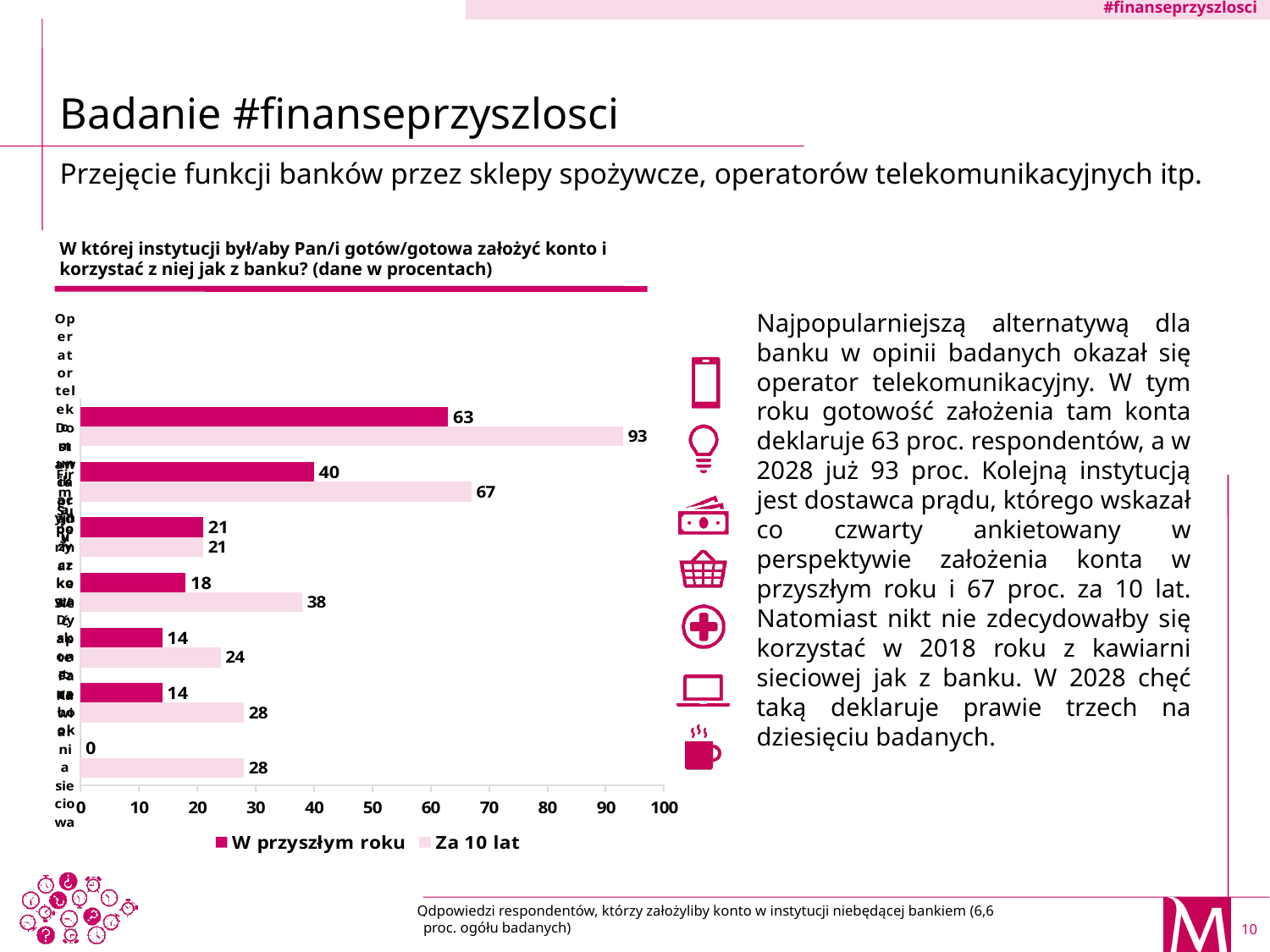
What is the highest value in the 'Za 10 lat' series? 93 What are the two series named in the chart legend? W przyszłym roku; Za 10 lat For the topmost category, what is the difference between the 'Za 10 lat' value (93) and the 'W przyszłym roku' value (63)? 30 What is the 'Za 10 lat' value for the bottom category, whose 'W przyszłym roku' value is 0? 28 What is the lowest value in the 'W przyszłym roku' series? 0 What is the highest value in the 'W przyszłym roku' series? 63 What is the maximum value shown on the chart's horizontal axis? 100 How many categories (pairs of bars) are plotted in the chart? 7 What is the 'Za 10 lat' value for the topmost category in the chart? 93 How many series does the chart legend list? 2 For the second category from the top, which series has the larger value: 'W przyszłym roku' (40) or 'Za 10 lat' (67)? Za 10 lat What type of chart is shown on the slide? bar chart